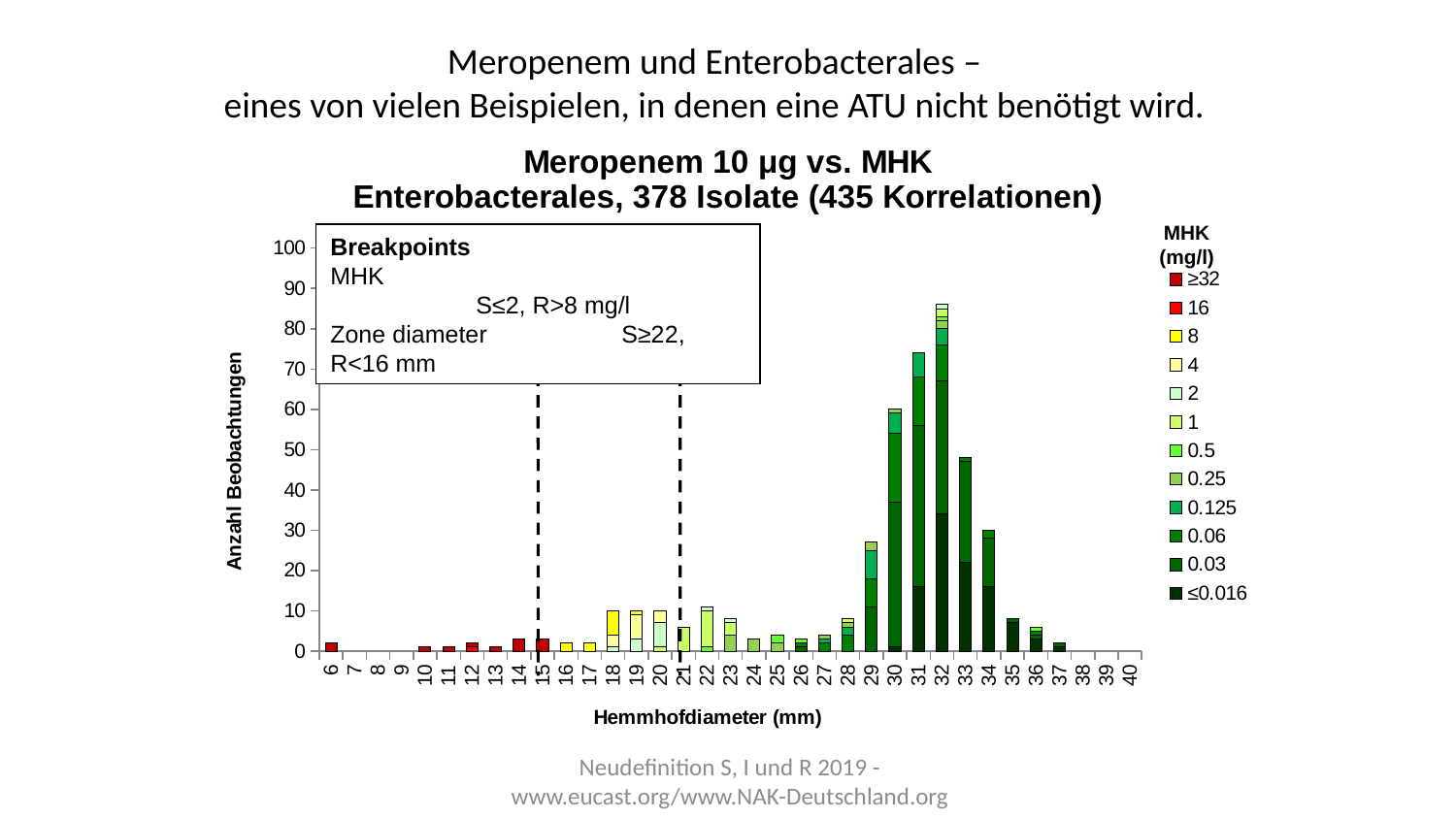
Is the total value for Hemmhofdiameter 34 mm greater or less than 40? less Which has the taller total bar: Hemmhofdiameter 33 mm or 34 mm? 33 mm Which has the taller total bar: Hemmhofdiameter 31 mm or 32 mm? 32 mm How many Hemmhofdiameter categories are shown on the x axis (from 6 to 40)? 35 What is the label of the y axis? Anzahl Beobachtungen At which Hemmhofdiameter (mm) is the total bar highest? 32 What is the label of the x axis? Hemmhofdiameter (mm) Is the total value for Hemmhofdiameter 18 mm greater or less than 20? less Is the total value for Hemmhofdiameter 32 mm greater or less than 80? greater How many series does the legend list? 12 What kind of chart is shown on the slide? Stacked bar chart